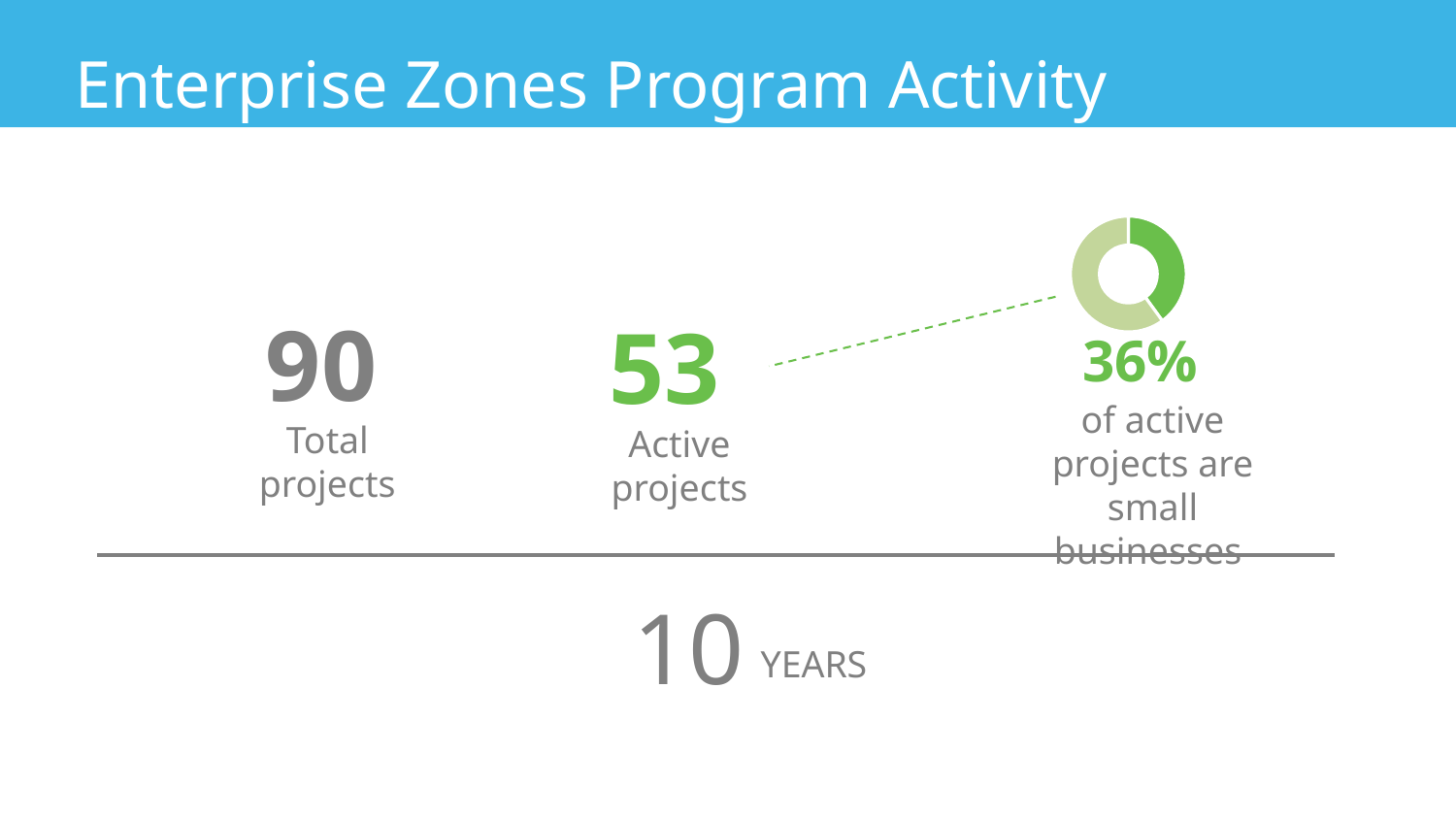
How many slices does the donut chart have? 2 Which slice of the donut chart is larger, the dark green slice or the light green slice? The light green slice How many total projects are reported on the slide? 90 What percentage of active projects are small businesses, according to the donut chart? 36% What kind of chart is shown on the slide? Donut chart Is the dark green slice of the donut chart greater or less than 50% of the whole? less Which figure on the slide does the dashed line connect the donut chart to? 53 Active projects What colour is the slice of the donut chart that represents small businesses? Dark green What is the difference between total projects and active projects on the slide? 37 How many active projects are reported on the slide? 53